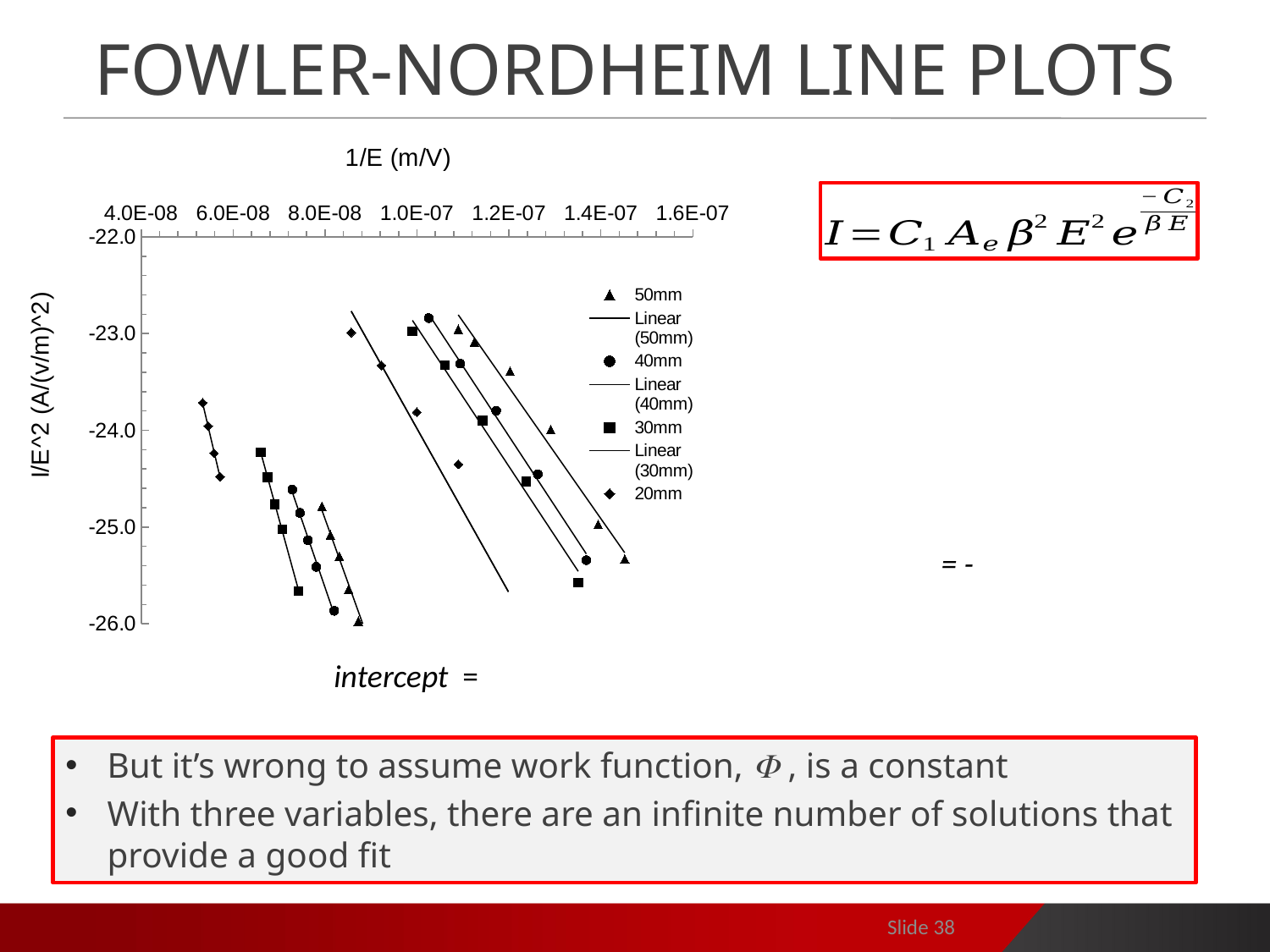
Do the plotted values rise or fall as 1/E increases along the x axis? Fall What kind of chart is shown on the slide? Scatter plot with linear trendlines How many entries does the chart legend list? 7 What marker shape is used for the 50mm series? Triangle What is the largest tick value shown on the x axis? 1.6E-07 Which series in the legend has no linear trendline entry? 20mm